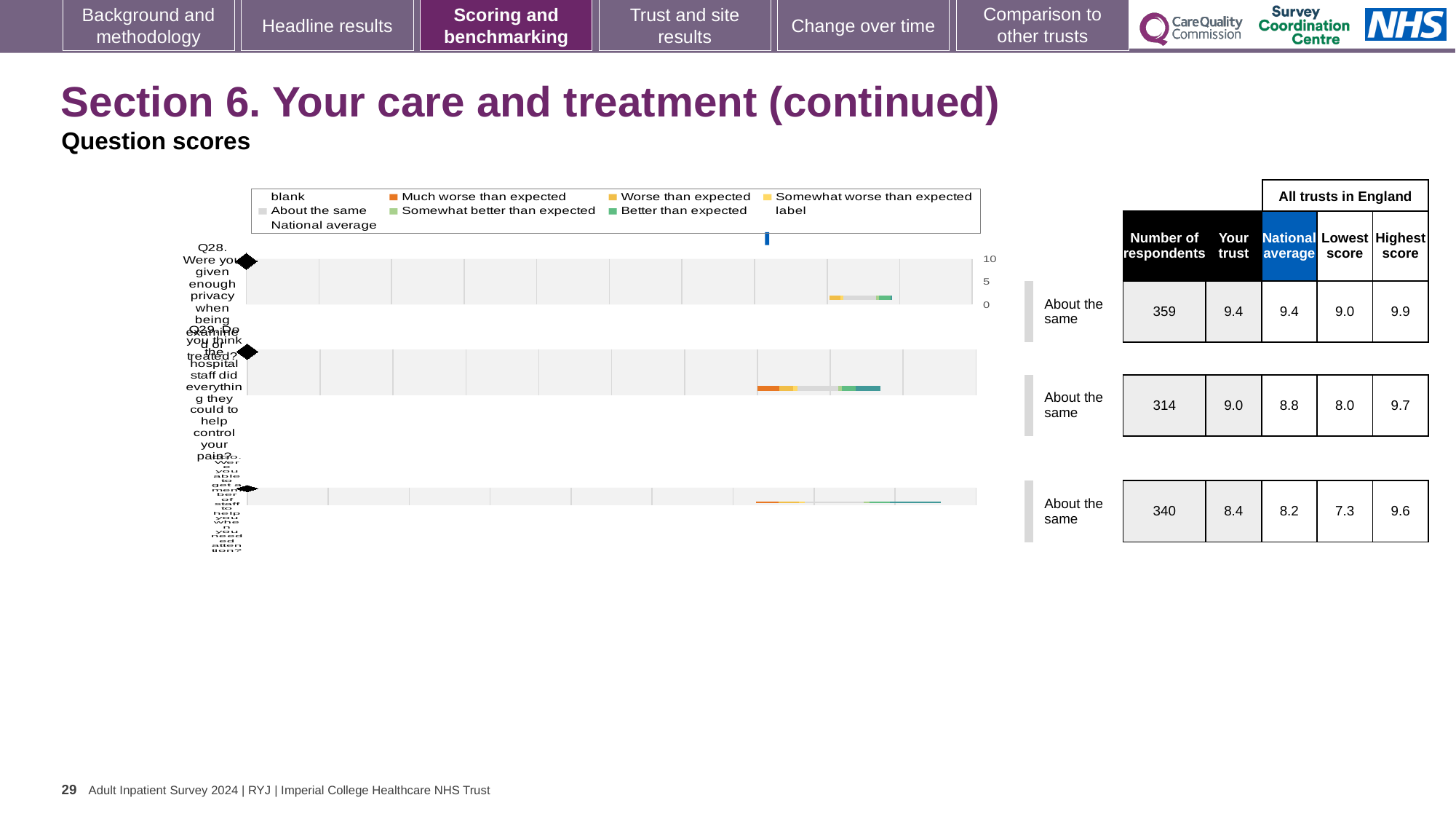
What benchmark category is shown for Q28? About the same What is the national average score for Q30? 8.2 Which question has the highest 'Your trust' score? Q28 What is the 'Your trust' score for Q28 (Were you given enough privacy when being examined or treated?)? 9.4 What is the lowest score among all trusts in England for Q30? 7.3 Which question has the lowest 'Your trust' score? Q30 For Q30, which is larger: the 'Your trust' score or the national average? Your trust How many survey questions are plotted in the chart? 3 For Q29, what is the difference between the 'Your trust' score and the national average? 0.2 What kind of chart is shown on the slide? bar chart What is the highest score among all trusts in England for Q28? 9.9 How many respondents are listed for Q29 (Do you think the hospital staff did everything they could to help control your pain?)? 314